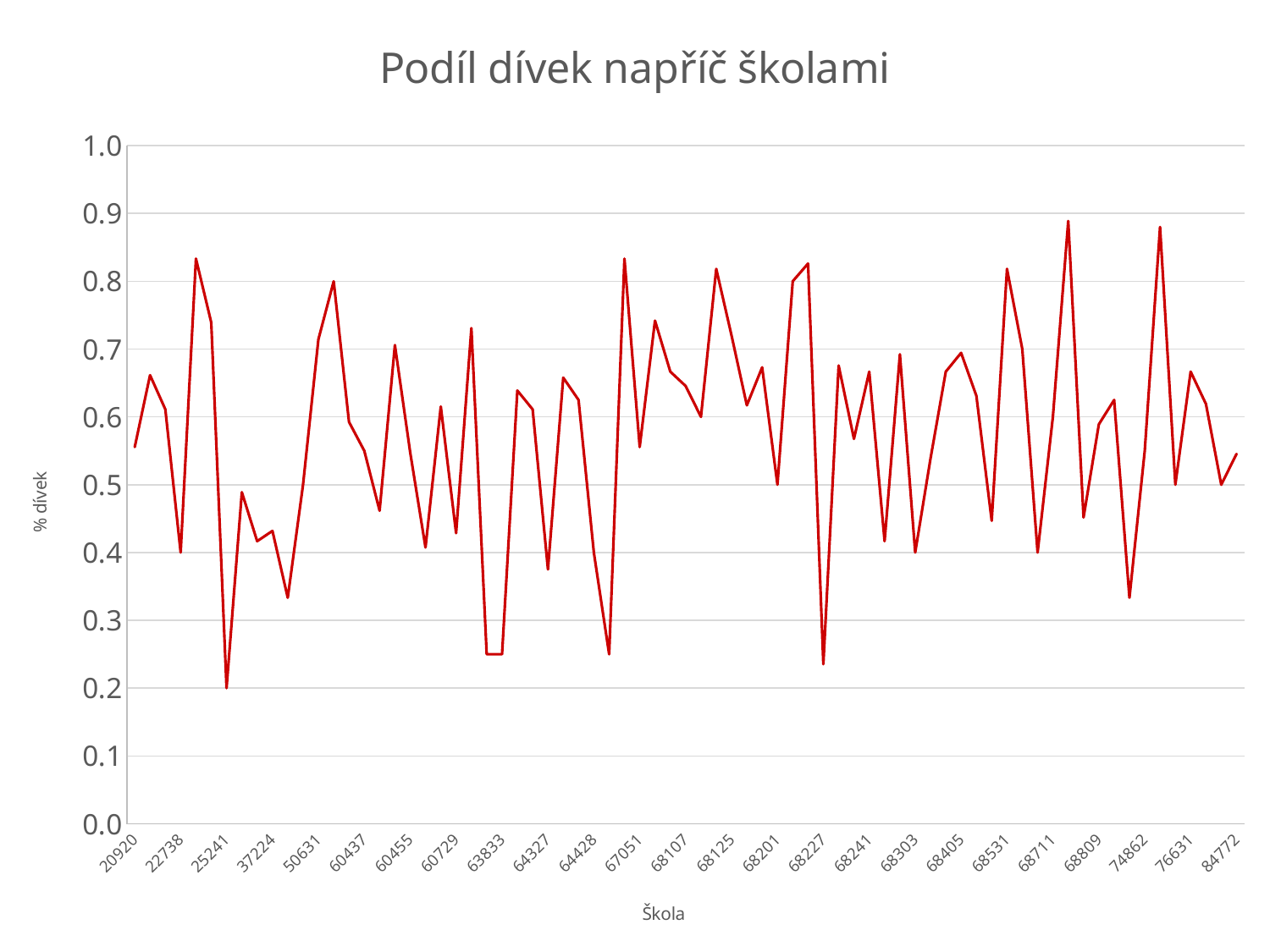
What is the title of the chart? Podíl dívek napříč školami What is the label of the vertical axis? % dívek Is the lowest value on the chart greater or less than 0.3? less Do the values show a steady rise or fall along the x axis, or do they fluctuate? fluctuate Is the highest value on the chart greater or less than 0.8? greater Is the value for school 84772 greater or less than 0.5? greater What kind of chart is shown on the slide? line chart